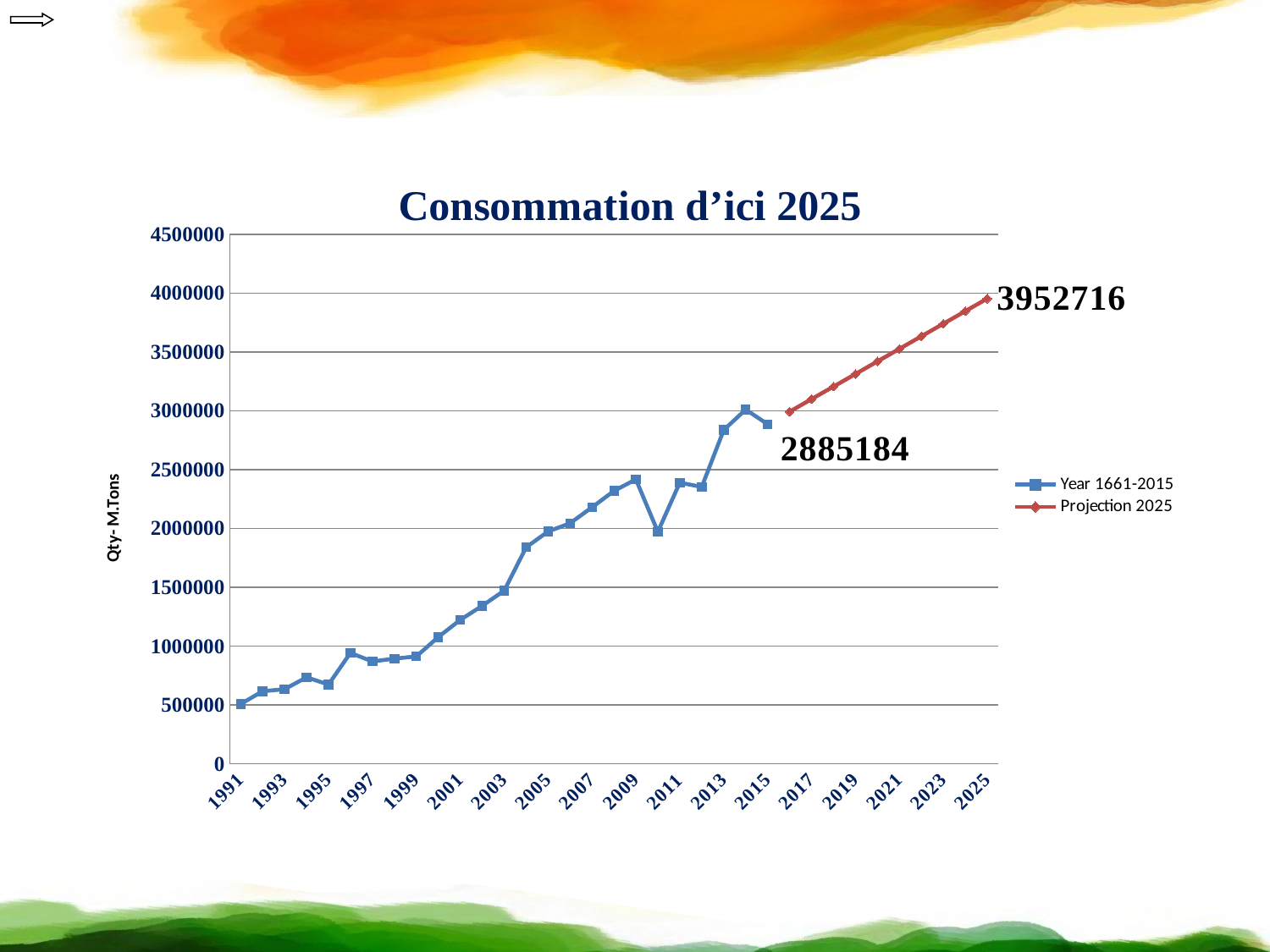
What kind of chart is shown on the slide? line chart Is the value for 2013 greater or less than 2500000? greater Is the value for 2009 greater or less than 2000000? greater What value is labelled on the chart for the year 2015? 2885184 What is the projected consumption value shown for 2025? 3952716 How many series does the legend list? 2 Which year has the lowest value on the chart? 1991 Which year has the highest value on the chart? 2025 Which year has the larger value, 2009 or 2010? 2009 What is the title of the chart? Consommation d’ici 2025 What is the difference between the labelled 2025 projection and the labelled 2015 value? 1067532 Is the value for 1991 greater or less than 1000000? less